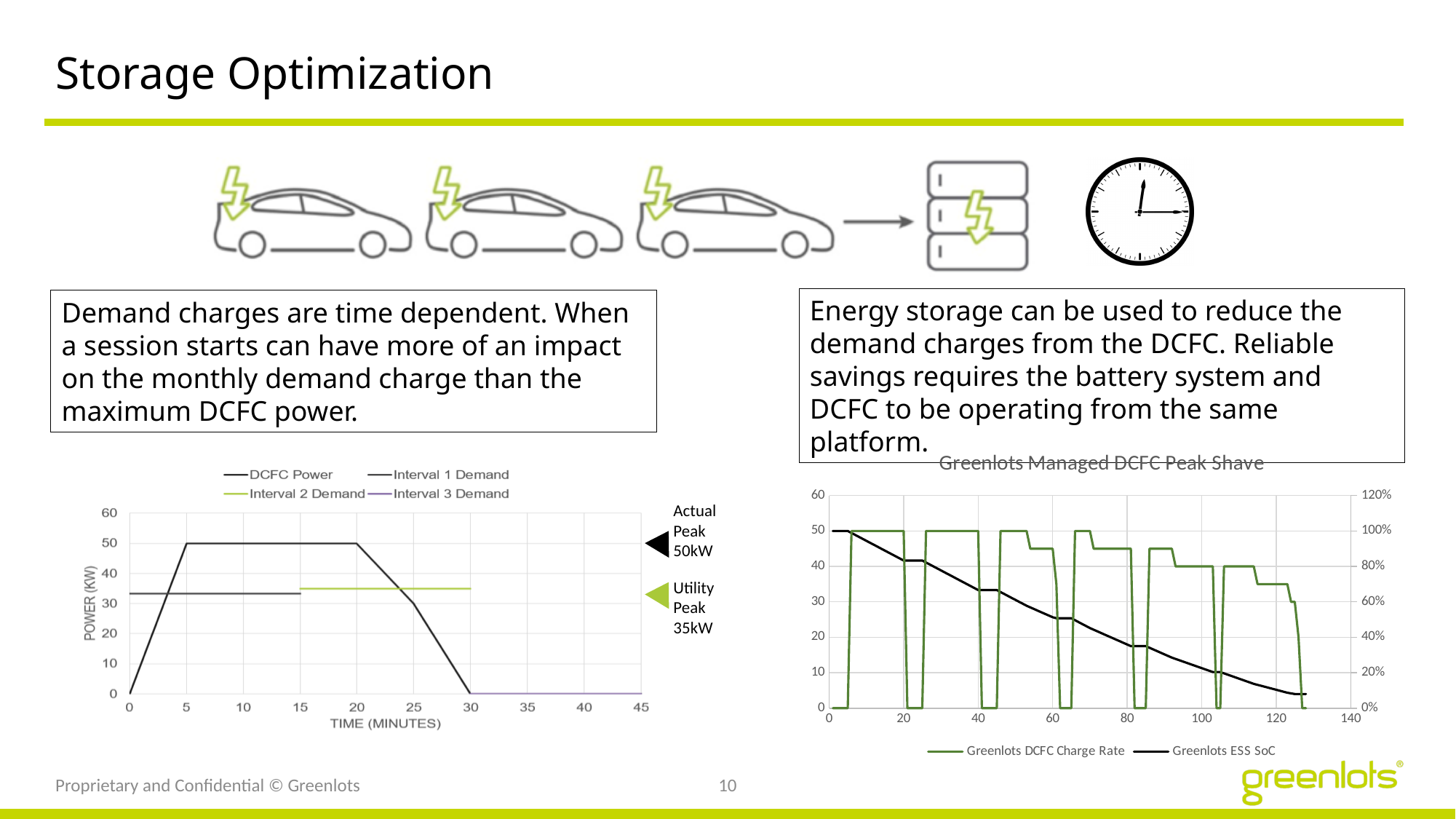
On the left chart, what is the DCFC Power value at 30 minutes? 0 On the left chart, is the Interval 1 Demand value greater or less than 30? greater What kind of chart is the left chart with the DCFC Power legend? line chart On the left chart, what is the DCFC Power value at 10 minutes? 50 On the Greenlots Managed DCFC Peak Shave chart, does the Greenlots ESS SoC line rise or fall along the x axis? fall On the left chart, what value is labelled as the Utility Peak? 35kW What is the x-axis label of the left chart? TIME (MINUTES) On the left chart, what value is labelled as the Actual Peak? 50kW How many series does the legend of the left chart list? 4 How many series does the legend of the Greenlots Managed DCFC Peak Shave chart list? 2 On the Greenlots Managed DCFC Peak Shave chart, what is the Greenlots ESS SoC value at time 0? 100% What is the title of the right chart? Greenlots Managed DCFC Peak Shave